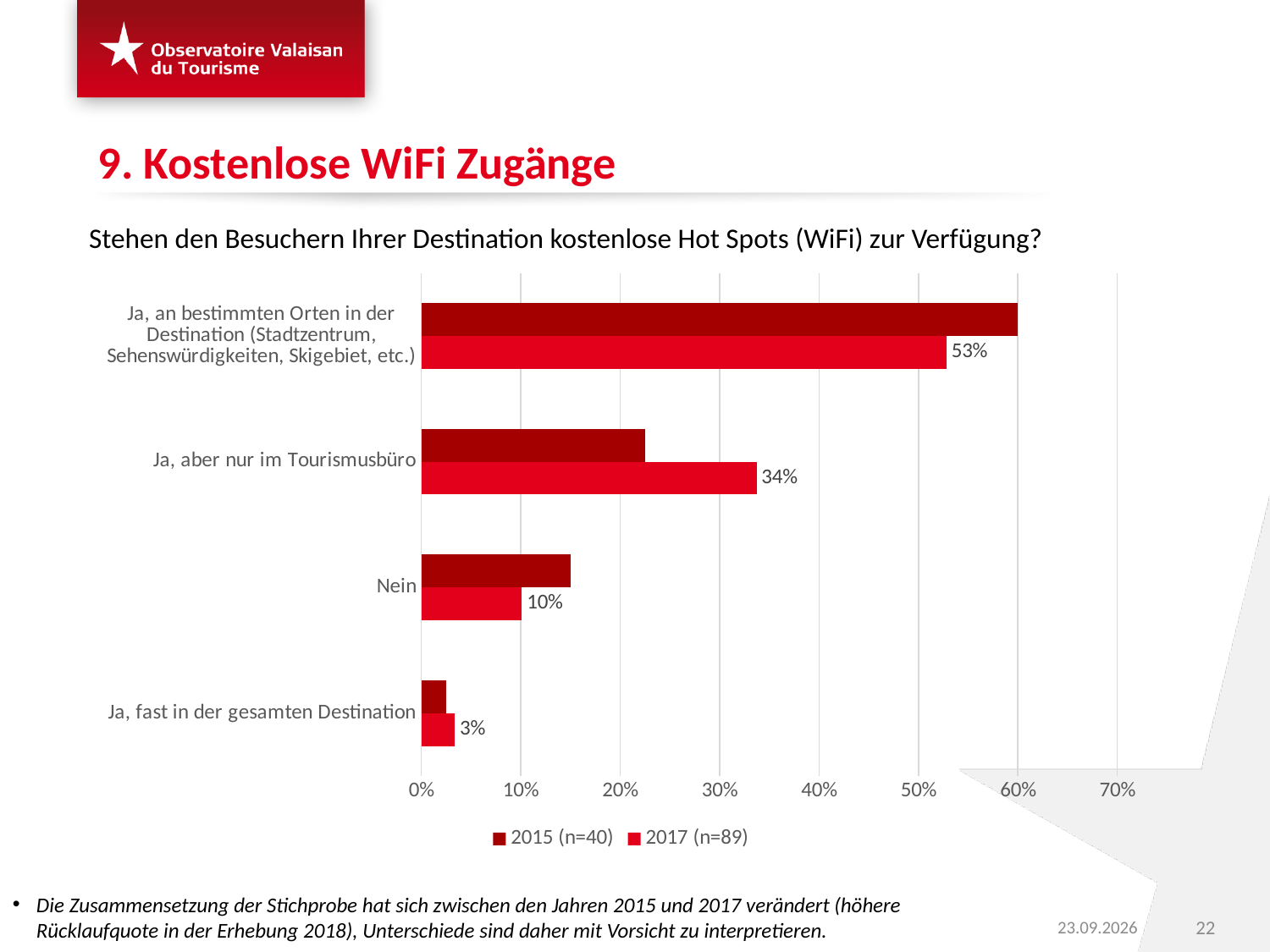
What is the difference between the 2017 (n=89) values for "Ja, aber nur im Tourismusbüro" and "Nein"? 24% What is the 2017 (n=89) value for "Ja, aber nur im Tourismusbüro"? 34% What is the 2017 (n=89) value for "Ja, fast in der gesamten Destination"? 3% What is the 2017 (n=89) value for "Ja, an bestimmten Orten in der Destination (Stadtzentrum, Sehenswürdigkeiten, Skigebiet, etc.)"? 53% What kind of chart is shown on the slide? Bar chart For "Ja, aber nur im Tourismusbüro", which series has the larger value, 2015 (n=40) or 2017 (n=89)? 2017 (n=89) Which category has the lowest 2017 (n=89) value? Ja, fast in der gesamten Destination How many series does the legend list? 2 Which category has the highest 2017 (n=89) value? Ja, an bestimmten Orten in der Destination (Stadtzentrum, Sehenswürdigkeiten, Skigebiet, etc.) How many categories are shown on the chart? 4 What is the 2017 (n=89) value for "Nein"? 10% Is the 2015 (n=40) value for "Ja, aber nur im Tourismusbüro" greater or less than 30%? less